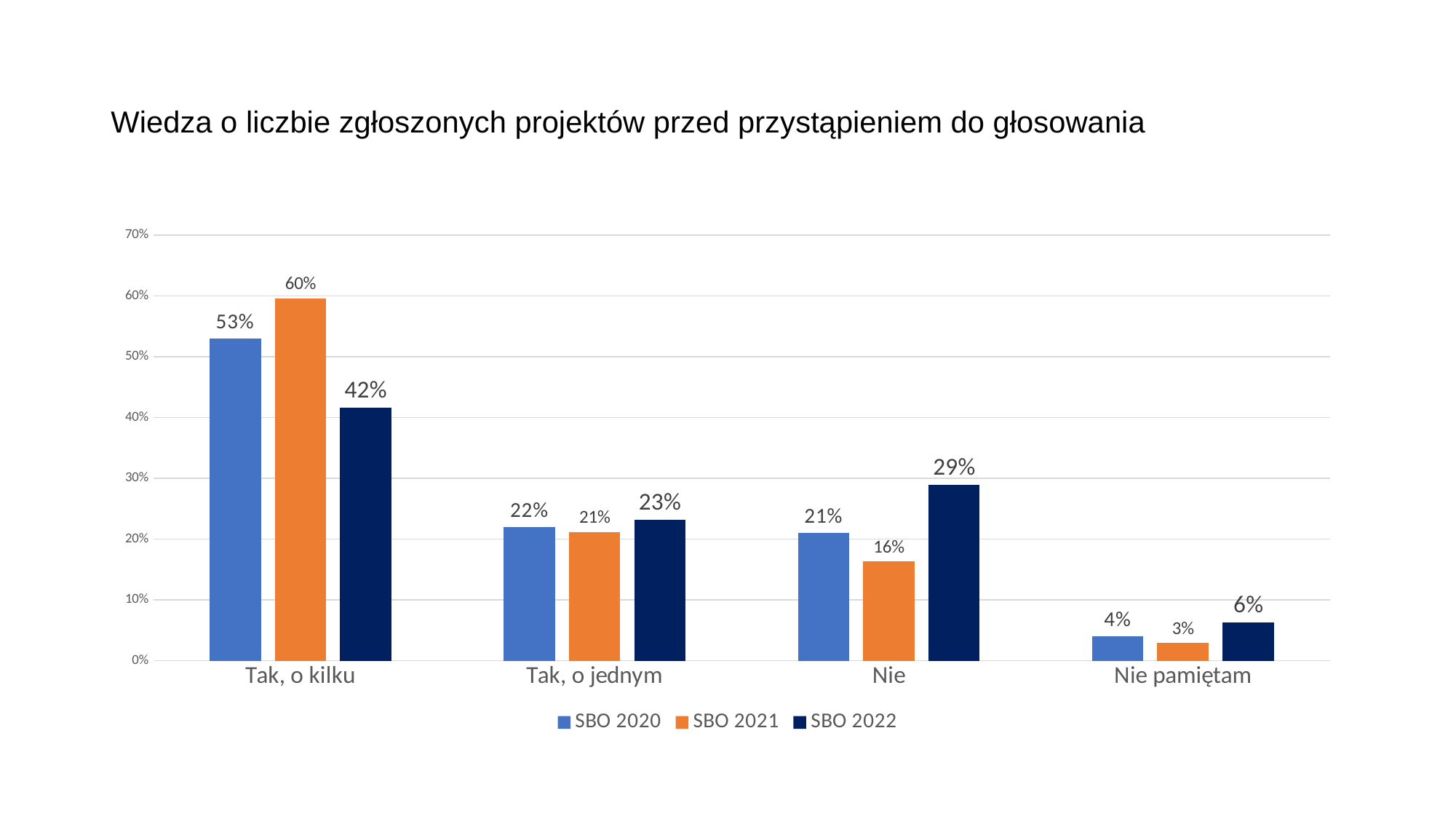
What is the value for SBO 2021 in the 'Tak, o kilku' category? 60% Which category has the lowest value for SBO 2021? Nie pamiętam What kind of chart is shown on the slide? Bar chart What is the title of the chart? Wiedza o liczbie zgłoszonych projektów przed przystąpieniem do głosowania Which category has the highest value for SBO 2022? Tak, o kilku How many categories are shown on the x axis? 4 What is the difference between the SBO 2021 and SBO 2022 values in the 'Tak, o kilku' category? 18% Which is larger in the 'Nie' category: SBO 2020 or SBO 2021? SBO 2020 What is the value for SBO 2022 in the 'Nie' category? 29% Is the value for SBO 2020 in the 'Tak, o kilku' category greater or less than 50%? greater How many series does the legend list? 3 What is the value for SBO 2020 in the 'Nie pamiętam' category? 4%